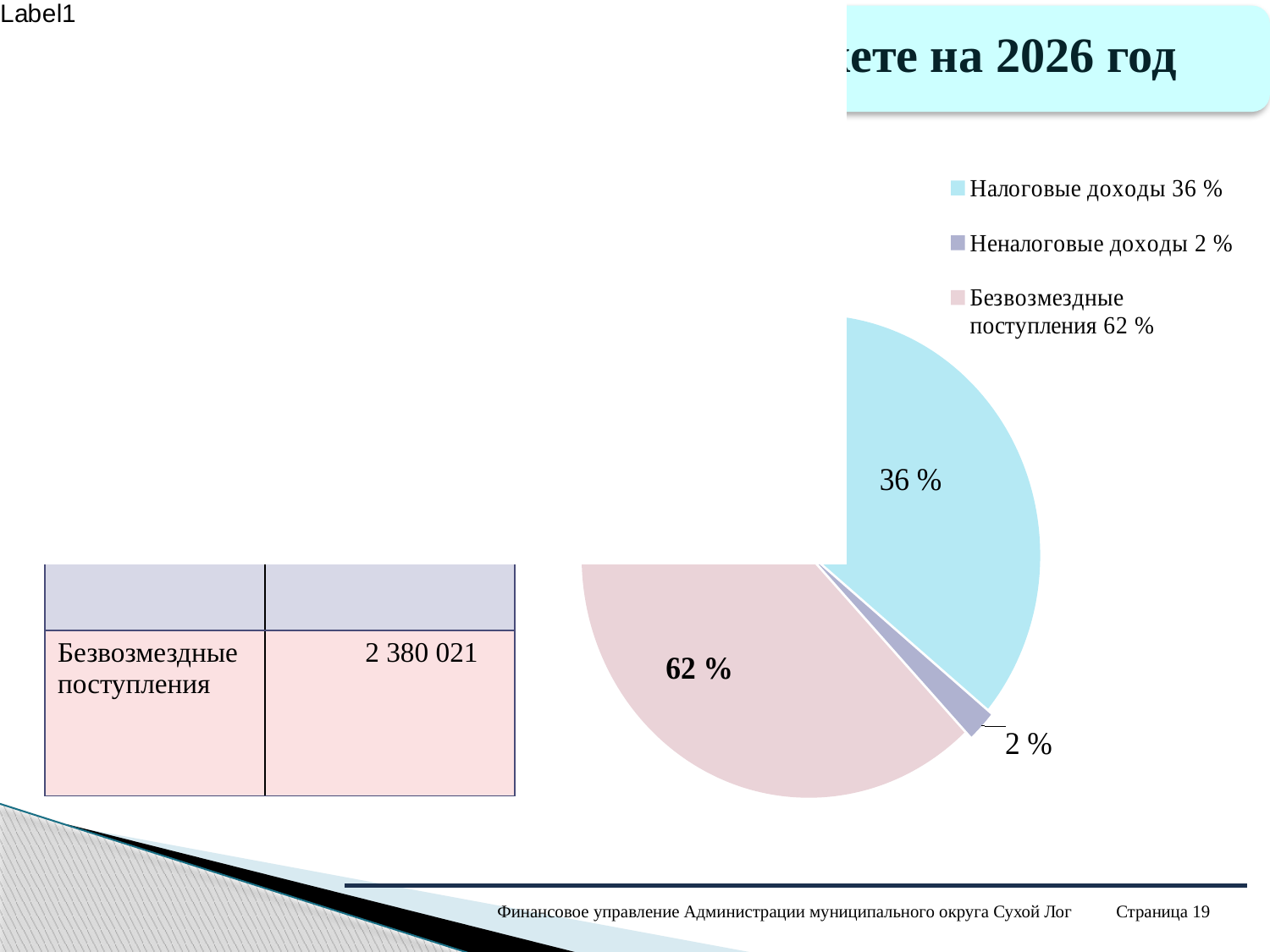
What share of the pie does Безвозмездные поступления take? 62 % How many entries does the legend of the pie chart list? 3 What share of the pie does Неналоговые доходы take? 2 % How many slices does the pie chart have? 3 Which slice of the pie chart is the largest? Безвозмездные поступления What colour is the Налоговые доходы slice in the pie chart? light blue What is the combined share of Налоговые доходы and Неналоговые доходы in the pie chart? 38 % What is the difference in percentage points between the Безвозмездные поступления slice and the Налоговые доходы slice? 26 Which is larger in the pie chart: Налоговые доходы or Неналоговые доходы? Налоговые доходы Which slice of the pie chart is the smallest? Неналоговые доходы What share of the pie does Налоговые доходы take? 36 % What kind of chart is shown on the slide? pie chart